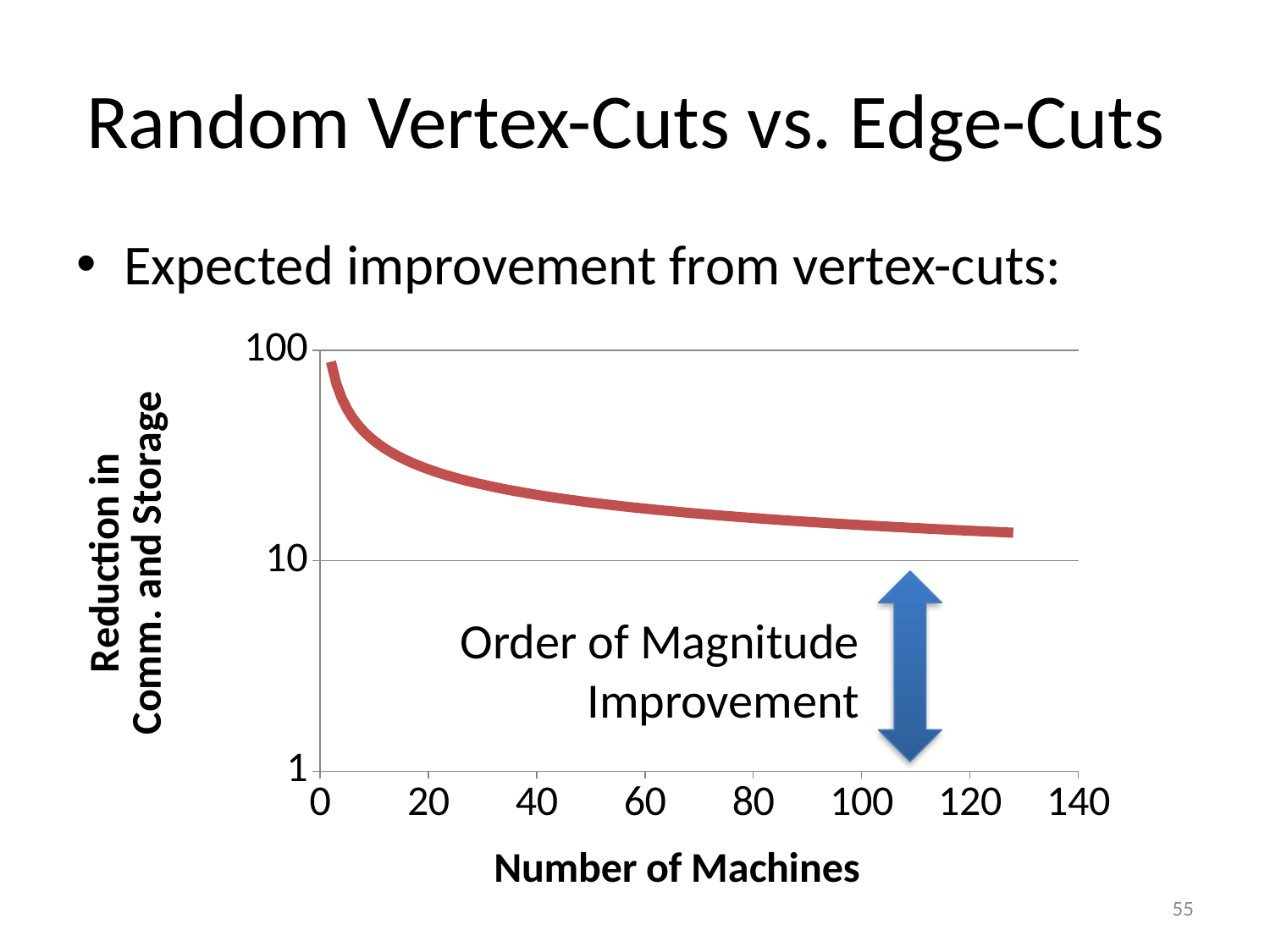
What is the label of the x axis? Number of Machines Is the value of the curve at 120 machines greater or less than 10? greater Is the value of the curve at 60 machines greater or less than 10? greater What is the largest tick value shown on the x axis? 140 Is the value of the curve at 100 machines greater or less than 100? less How many lines are plotted on the chart? 1 What kind of chart is shown on the slide? line chart What is the label of the y axis? Reduction in Comm. and Storage Does the plotted reduction in communication and storage rise or fall as the number of machines increases? fall